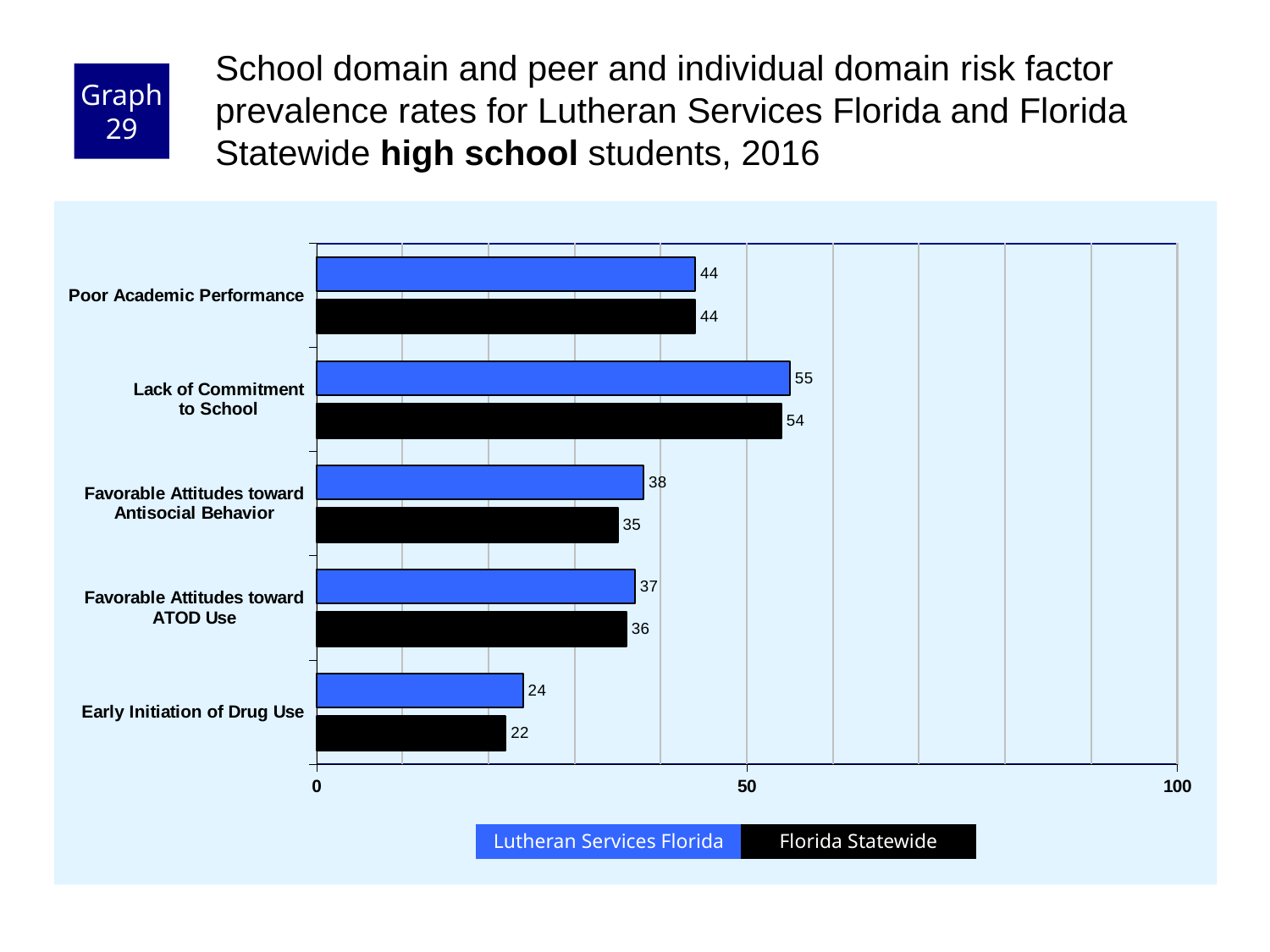
How many series does the legend list? 2 What is the Lutheran Services Florida value for Lack of Commitment to School? 55 What is the difference between the Lutheran Services Florida and Florida Statewide values for Favorable Attitudes toward Antisocial Behavior? 3 Which risk factor has the highest Lutheran Services Florida value? Lack of Commitment to School What is the Florida Statewide value for Early Initiation of Drug Use? 22 What is the Florida Statewide value for Favorable Attitudes toward Antisocial Behavior? 35 Which is larger for Early Initiation of Drug Use: the Lutheran Services Florida value or the Florida Statewide value? Lutheran Services Florida How many risk factors are shown on the chart? 5 What is the difference between the Lutheran Services Florida values for Lack of Commitment to School and Early Initiation of Drug Use? 31 Which risk factor has the lowest Florida Statewide value? Early Initiation of Drug Use What kind of chart is shown on the slide? bar chart Is the Lutheran Services Florida value for Lack of Commitment to School greater or less than 50? greater